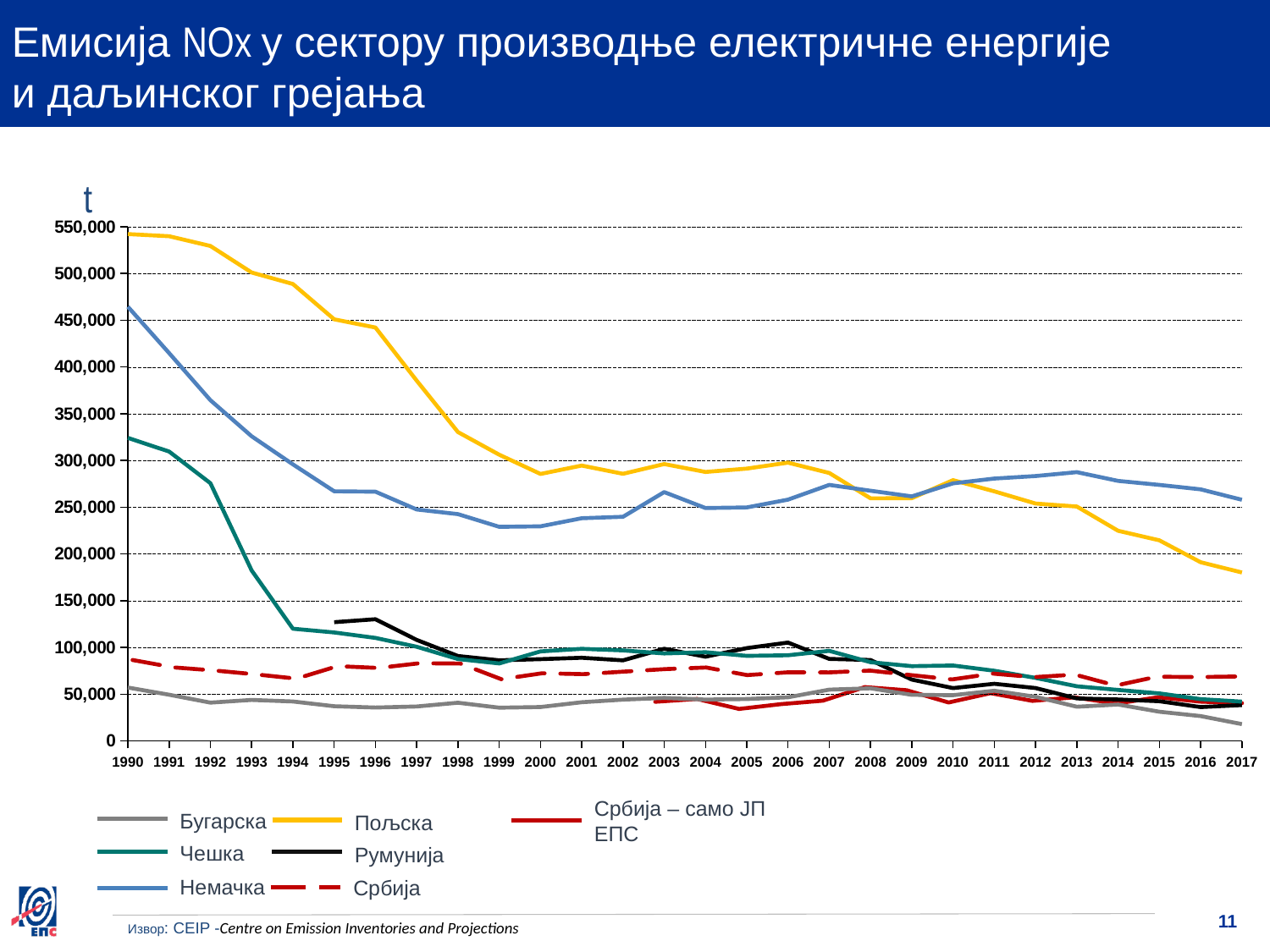
Is the value for Пољска in 2017 greater or less than 200,000? less In 2017, which is larger: the value for Немачка or the value for Пољска? Немачка Which country has the highest NOx emission in 1990? Пољска Does the value for Пољска rise or fall overall from 1990 to 2017? Fall Is the value for Бугарска in 2017 greater or less than 50,000? less What unit is shown at the top of the y axis? t Which series has the lowest value in 2017? Бугарска Is the value for Пољска in 1990 greater or less than 500,000? greater How many years are shown on the x axis? 28 What kind of chart is shown on the slide? Line chart How many series does the legend list? 7